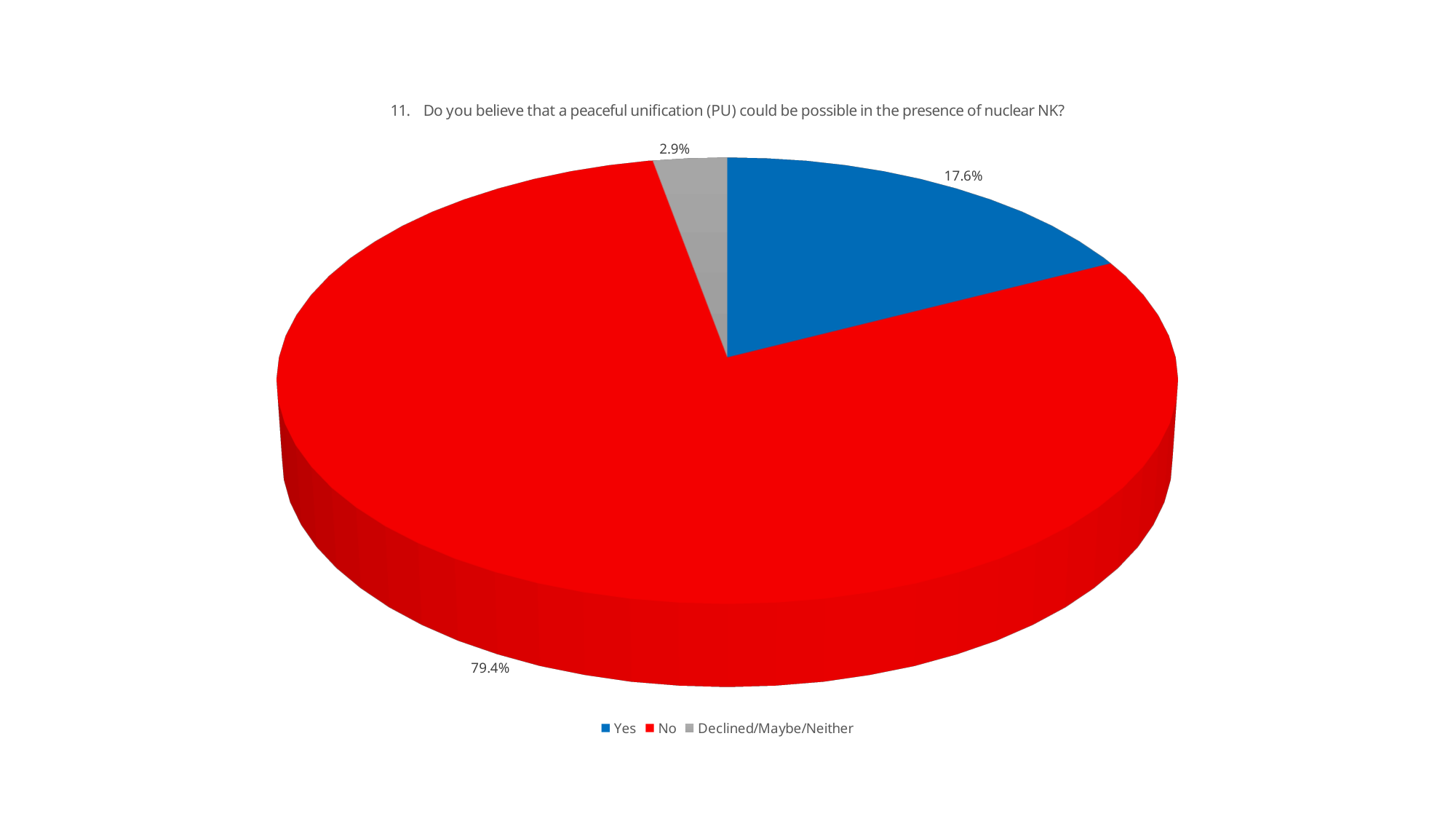
Which response has the smallest share of the pie? Declined/Maybe/Neither How many slices does the pie chart have? 3 What kind of chart is shown on the slide? Pie chart What is the difference in percentage points between the "No" and "Yes" slices? 61.8 What is the title of the chart? 11. Do you believe that a peaceful unification (PU) could be possible in the presence of nuclear NK? What percentage of respondents answered "No"? 79.4% What colour is the "No" slice? Red What is the difference in percentage points between the "Yes" and "Declined/Maybe/Neither" slices? 14.7 What percentage of respondents are in the "Declined/Maybe/Neither" category? 2.9% Which is larger, the "Yes" slice or the "Declined/Maybe/Neither" slice? Yes What percentage of respondents answered "Yes"? 17.6% Which response has the largest share of the pie? No